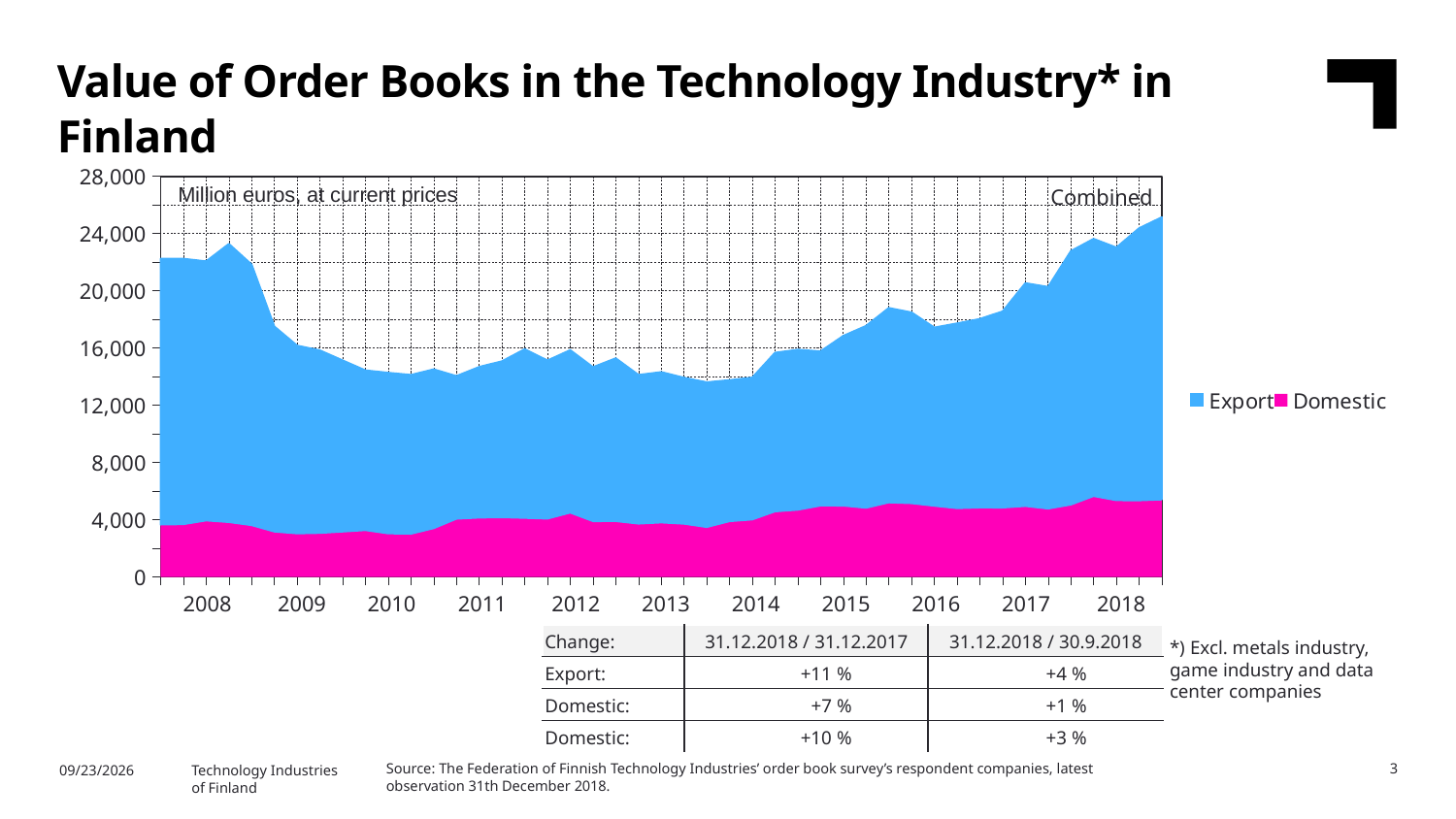
In which year does the combined value reach its highest level? 2018 What type of chart is shown on the slide? Stacked area chart What unit is stated in the chart's subtitle? Million euros, at current prices Does the combined value rise or fall from 2016 to 2018? rise Is the combined value at the end of 2018 greater or less than 24,000? greater How many series does the legend list? 2 How many year labels are shown on the x axis? 11 Is the Domestic value in 2010 greater or less than 4,000? less Is the combined value in 2013 greater or less than 16,000? less Which two series are shown in the legend? Export and Domestic According to the table below the chart, what is the Export change for 31.12.2018 / 31.12.2017? +11 %